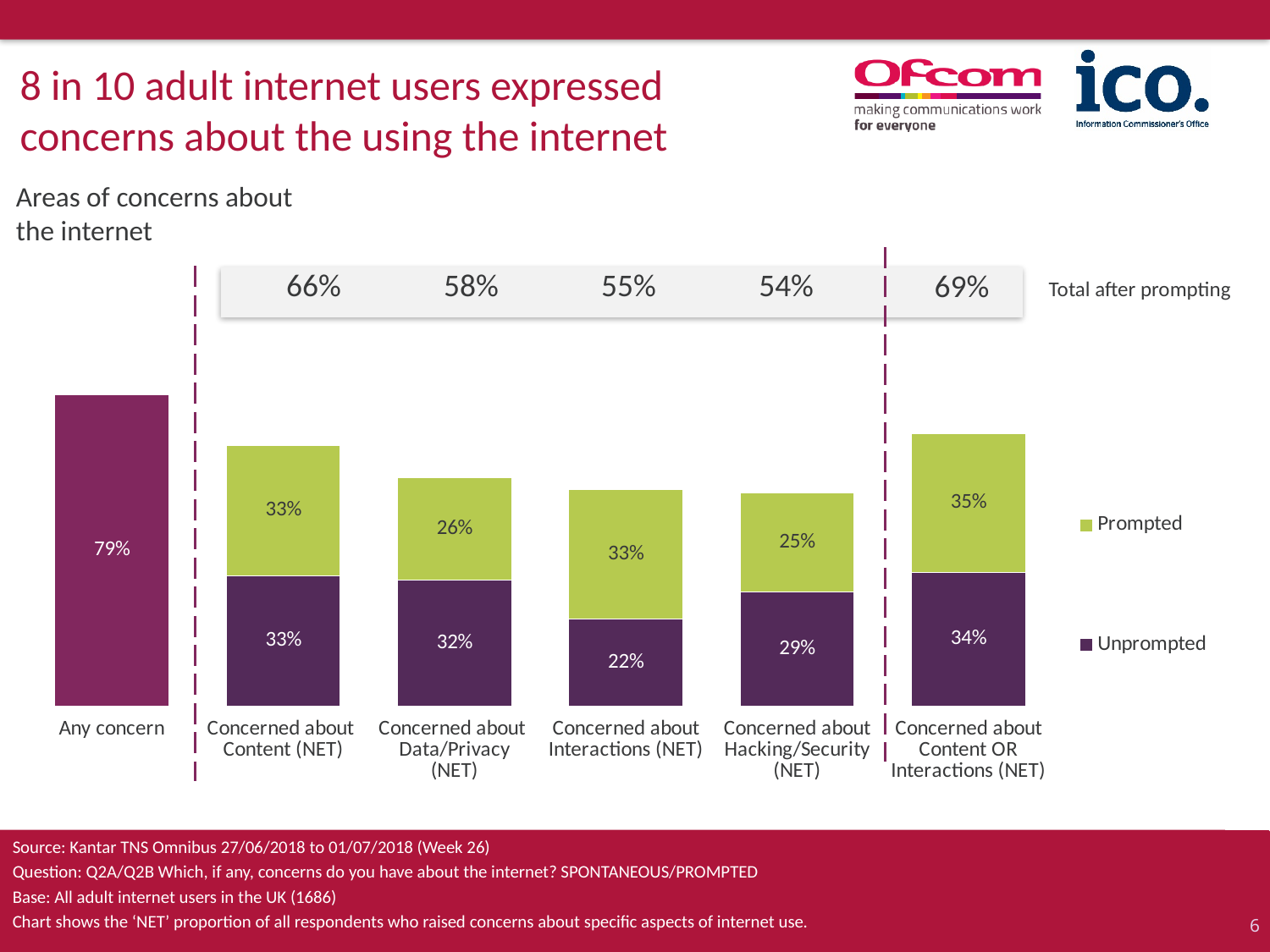
What is the total of the stacked bar for Concerned about Content (NET)? 66% What is the total after prompting for Concerned about Data/Privacy (NET)? 58% Which is larger: the Unprompted value for Concerned about Data/Privacy (NET) or the Unprompted value for Concerned about Hacking/Security (NET)? Concerned about Data/Privacy (NET) How many categories are shown on the x axis of the chart? 6 What is the value for Any concern? 79% What is the Unprompted value for Concerned about Interactions (NET)? 22% How many series does the legend list? 2 Which of the NET concern categories has the lowest total after prompting? Concerned about Hacking/Security (NET) What is the difference between the Prompted and Unprompted values for Concerned about Interactions (NET)? 11% What is the Prompted value for Concerned about Content OR Interactions (NET)? 35% Which of the NET concern categories has the highest total after prompting? Concerned about Content OR Interactions (NET) What kind of chart is shown on the slide? Stacked bar chart